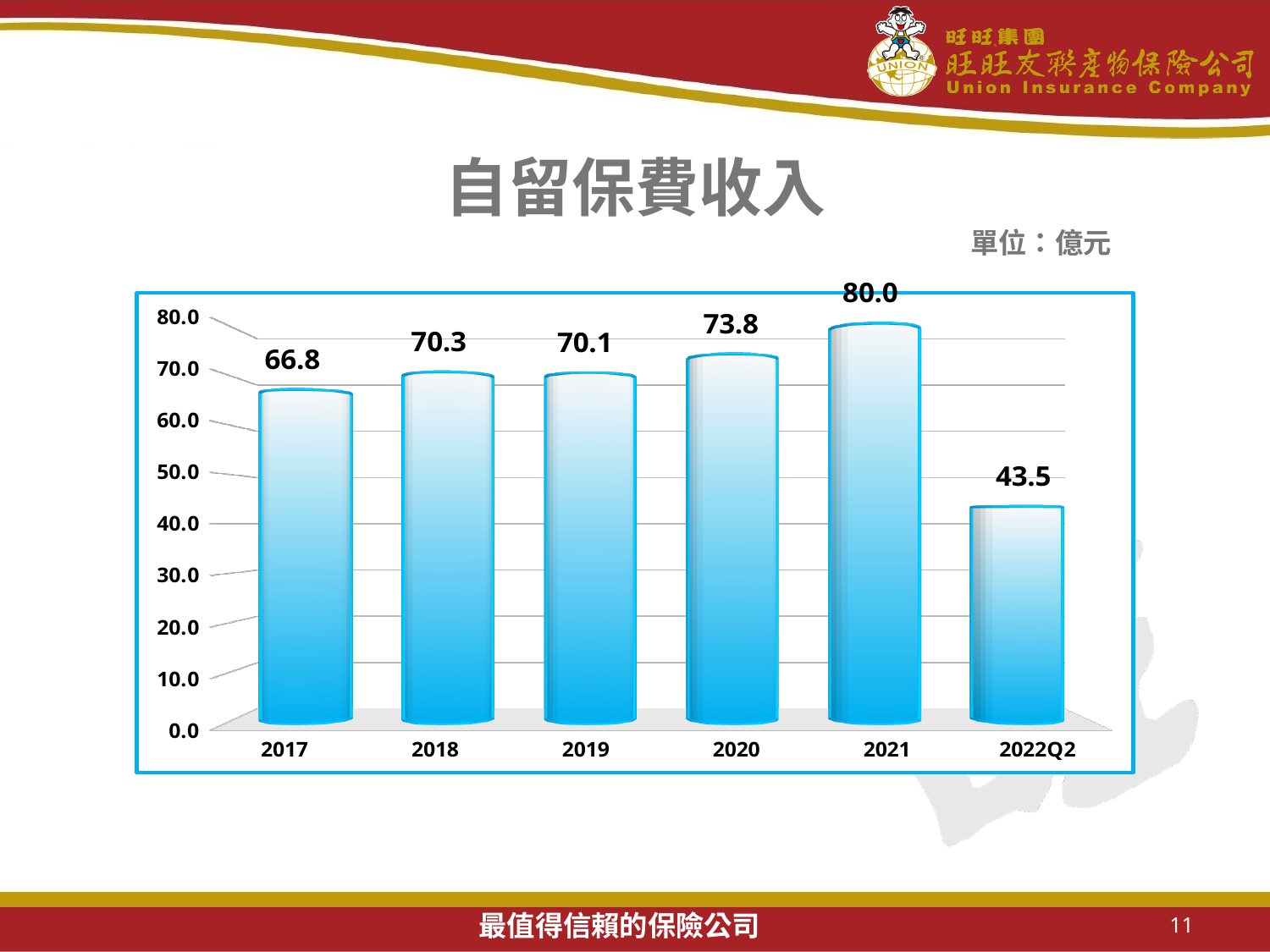
What is the difference between the values for 2021 and 2020? 6.2 What is the difference between the values for 2018 and 2017? 3.5 What is the value for 2020? 73.8 What is the value for 2022Q2? 43.5 Which category has the highest value? 2021 What is the value for 2017? 66.8 Which is larger, the value for 2019 or the value for 2020? 2020 How many categories are shown on the x axis? 6 Is the value for 2021 greater or less than 70.0? greater What is the title of the chart? 自留保費收入 What kind of chart is shown on the slide? bar chart Which category has the lowest value? 2022Q2